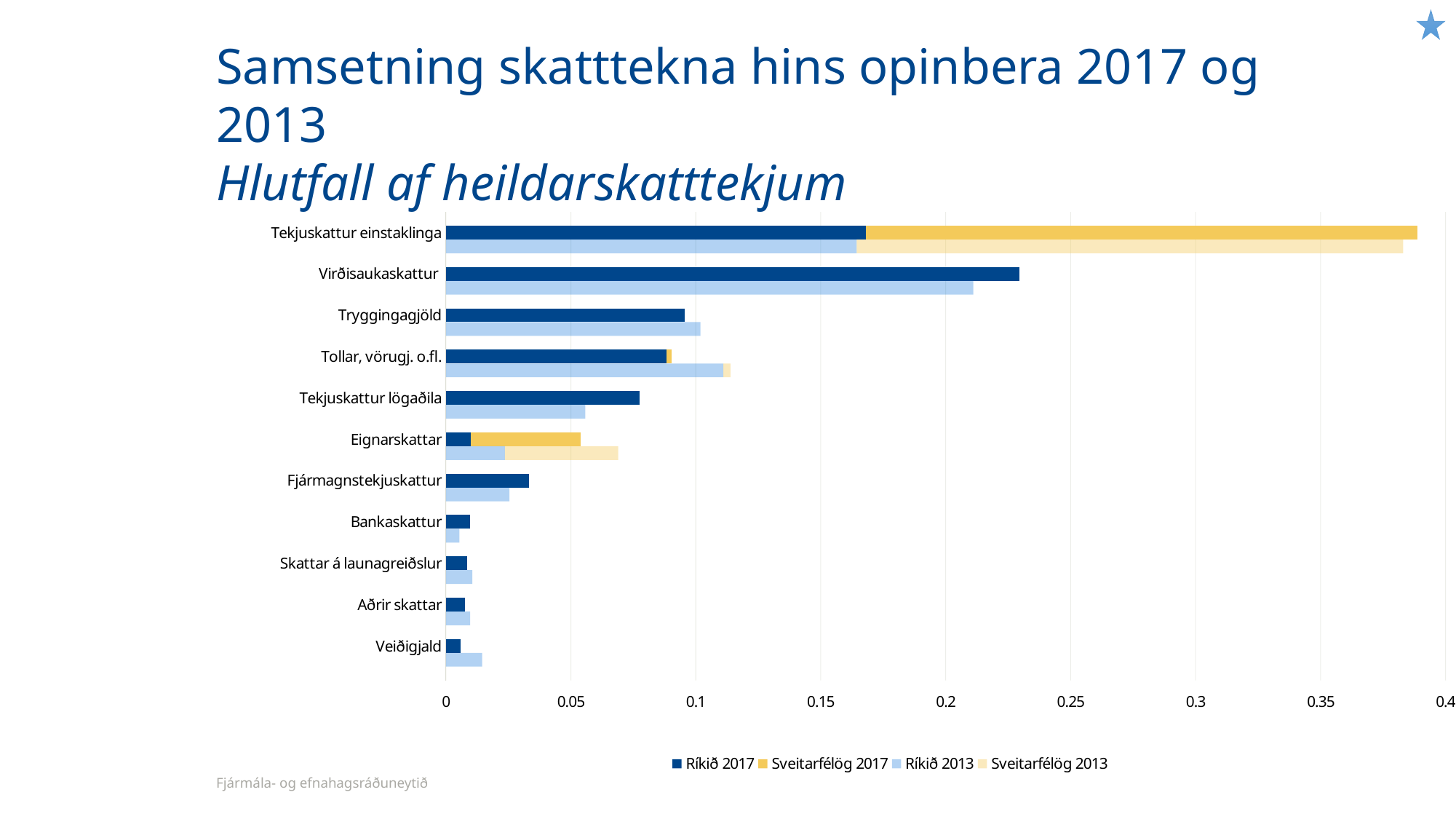
How many tax categories are listed on the vertical axis of the chart? 11 Is the Ríkið 2017 value for Virðisaukaskattur greater or less than 0.2? greater Which is larger for Virðisaukaskattur or Tryggingagjöld: the Ríkið 2017 value? Virðisaukaskattur Is the Ríkið 2017 value for Tryggingagjöld greater or less than 0.1? less What kind of chart is shown on the slide? bar chart How many series does the chart legend list? 4 For Veiðigjald, which is larger: the Ríkið 2013 value or the Ríkið 2017 value? Ríkið 2013 Which category has the longest bar in the chart? Tekjuskattur einstaklinga Is the Ríkið 2017 value for Tekjuskattur lögaðila greater or less than 0.05? greater Which series in the legend is shown in dark blue? Ríkið 2017 For Tekjuskattur lögaðila, which is larger: the Ríkið 2017 value or the Ríkið 2013 value? Ríkið 2017